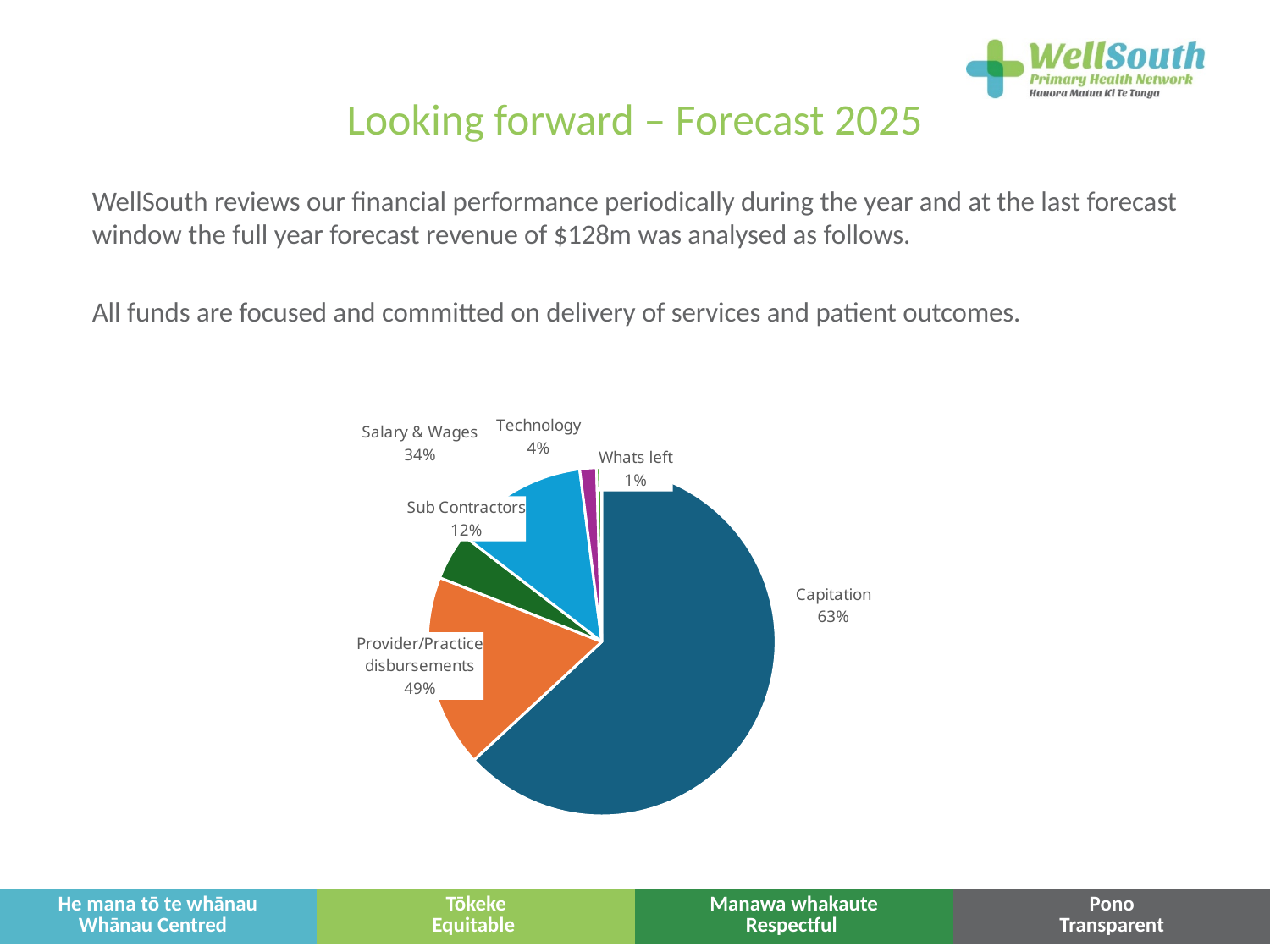
Which slice of the pie chart has the smallest percentage? Whats left What percentage is shown for the Capitation slice? 63% How many slices does the pie chart have? 6 What is the title of the slide containing the pie chart? Looking forward – Forecast 2025 What kind of chart is shown on the slide? Pie chart What percentage is shown for Technology? 4% What percentage is shown for Provider/Practice disbursements? 49% Which slice of the pie chart has the largest percentage? Capitation What percentage is shown for Sub Contractors? 12% What percentage is shown for Salary & Wages? 34% Which is larger, Salary & Wages or Sub Contractors? Salary & Wages What is the difference in percentage points between Capitation and Provider/Practice disbursements? 14%